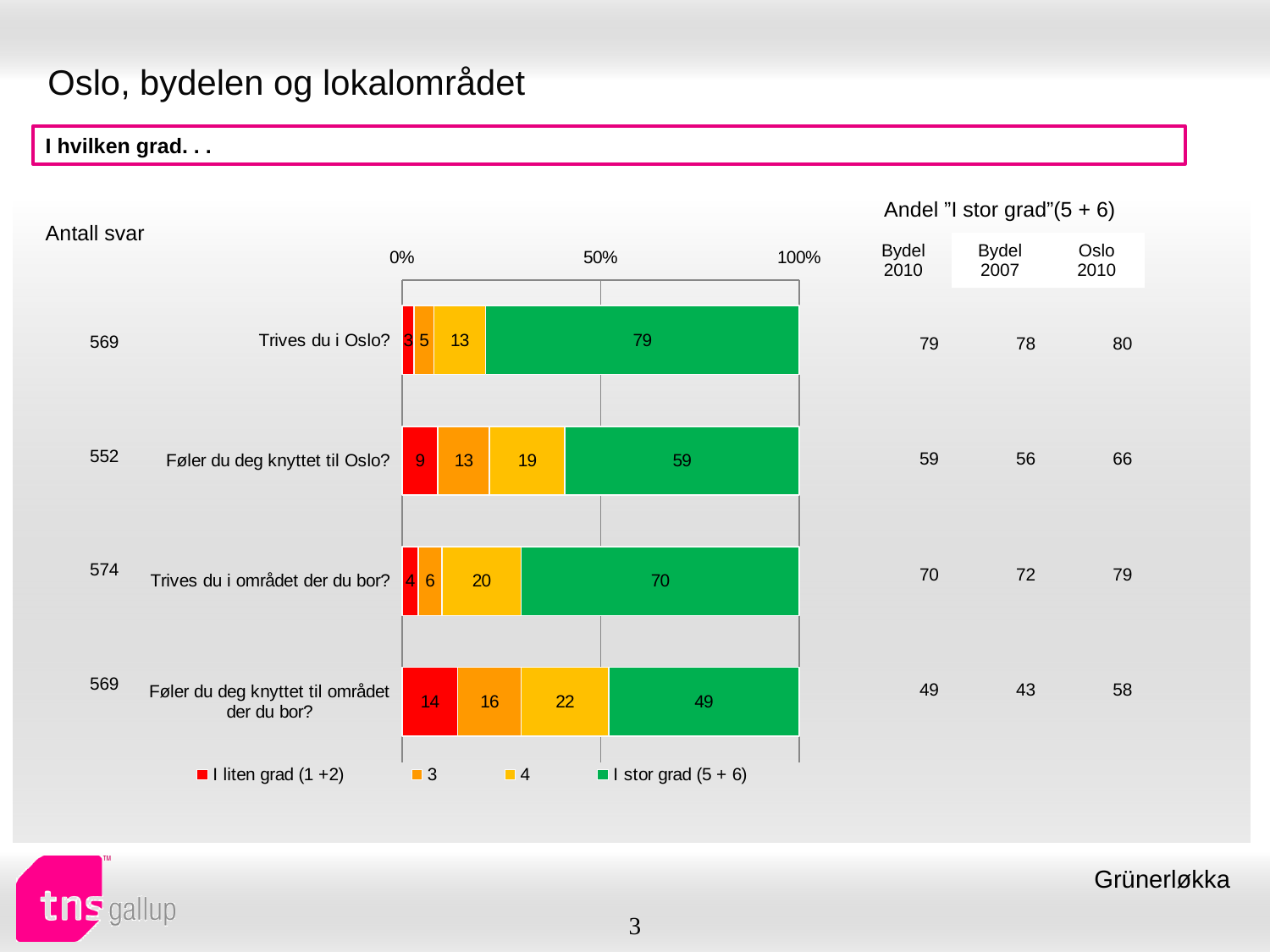
What is the difference between the "I stor grad (5 + 6)" values for "Trives du i Oslo?" and "Føler du deg knyttet til Oslo?"? 20 What is the total of the stacked bar for "Trives du i Oslo?"? 100 How many categories are shown in the bar chart? 4 What is the value of series "4" for "Føler du deg knyttet til Oslo?"? 19 Which category has the highest value for "I stor grad (5 + 6)"? Trives du i Oslo? Which is larger: the "I liten grad (1 +2)" value for "Føler du deg knyttet til Oslo?" or for "Trives du i området der du bor?"? Føler du deg knyttet til Oslo? What kind of chart is shown on the slide? Stacked bar chart What is the value of series "3" for "Trives du i området der du bor?"? 6 Which category has the lowest value for "I stor grad (5 + 6)"? Føler du deg knyttet til området der du bor? What is the value of "I stor grad (5 + 6)" for "Trives du i Oslo?"? 79 What is the value of "I liten grad (1 +2)" for "Føler du deg knyttet til området der du bor?"? 14 How many series does the legend list? 4